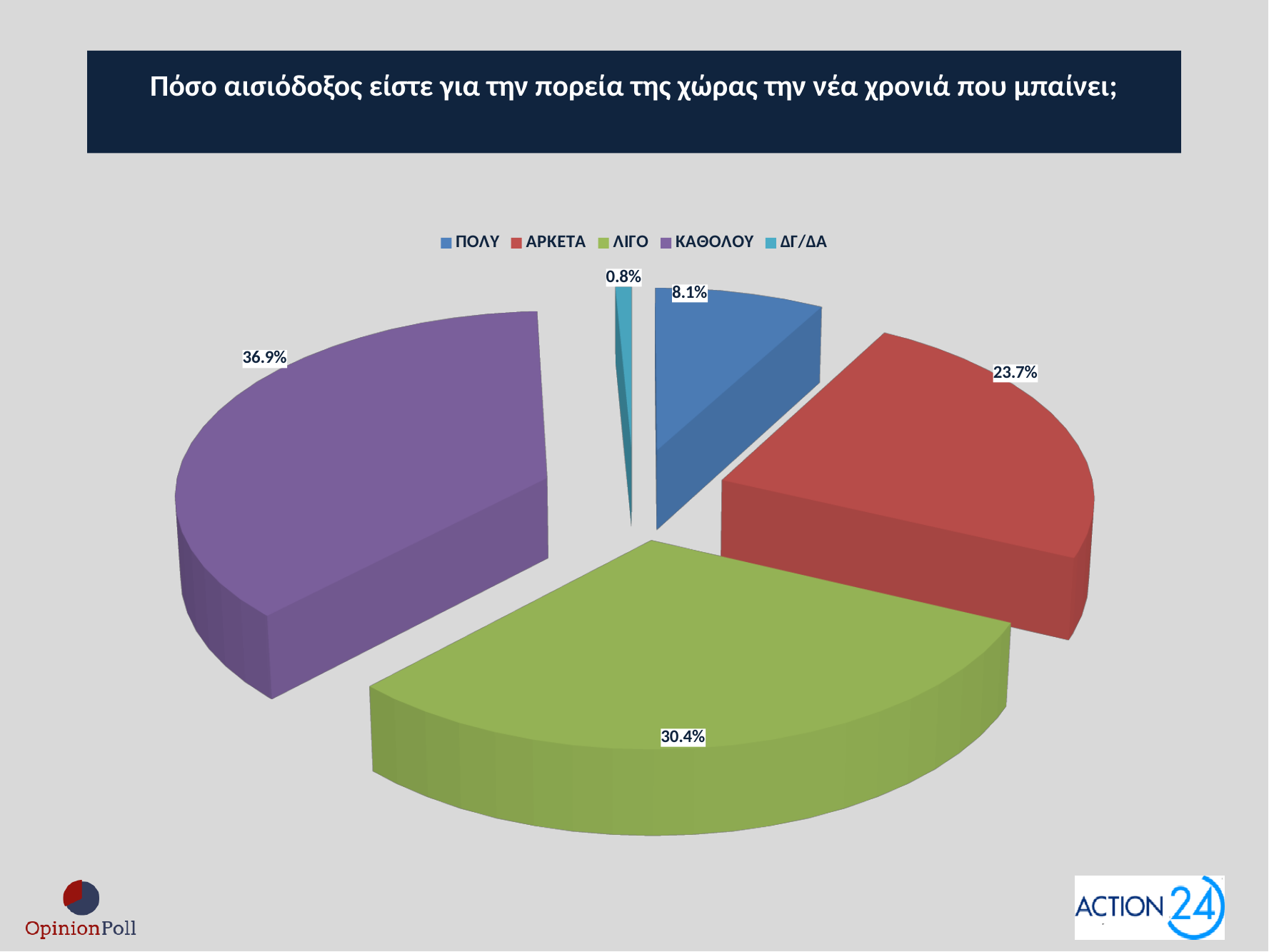
What colour is the slice for ΛΙΓΟ? Green What is the value for ΔΓ/ΔΑ? 0.8% What is the value for ΑΡΚΕΤΑ? 23.7% What type of chart is shown on the slide? Pie chart What is the value for ΠΟΛΥ? 8.1% How many categories does the legend list? 5 What is the value for ΛΙΓΟ? 30.4% What is the value for ΚΑΘΟΛΟΥ? 36.9% Which category has the largest share of the pie? ΚΑΘΟΛΟΥ Which category has the smallest share of the pie? ΔΓ/ΔΑ Which is larger, the value for ΑΡΚΕΤΑ or the value for ΠΟΛΥ? ΑΡΚΕΤΑ What is the difference between the values for ΚΑΘΟΛΟΥ and ΛΙΓΟ? 6.5%